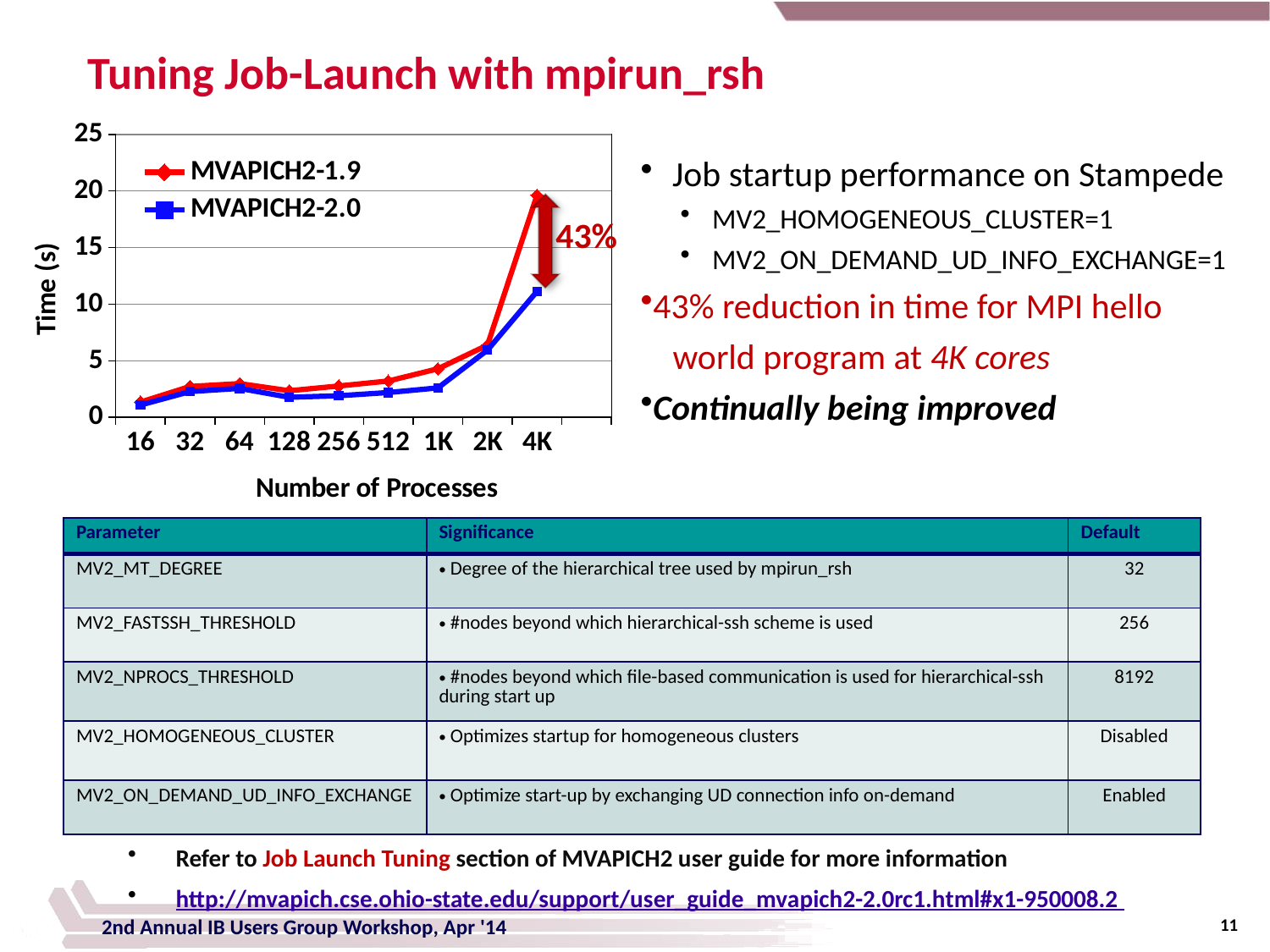
Is the time for MVAPICH2-1.9 at 4K processes greater or less than 15? greater What kind of chart is shown on the slide? line chart Which two series are shown in the chart legend? MVAPICH2-1.9 and MVAPICH2-2.0 How many process counts are plotted along the x axis of the chart? 9 Do the times for MVAPICH2-1.9 generally rise or fall as the number of processes increases? rise What is the label of the y axis of the chart? Time (s) Is the time for MVAPICH2-2.0 at 16 processes greater or less than 5? less How many series does the chart legend list? 2 At 4K processes, which series has the higher time, MVAPICH2-1.9 or MVAPICH2-2.0? MVAPICH2-1.9 At which number of processes does MVAPICH2-2.0 have its lowest time? 16 At which number of processes does MVAPICH2-1.9 reach its highest time? 4K Is the time for MVAPICH2-2.0 at 4K processes greater or less than 10? greater